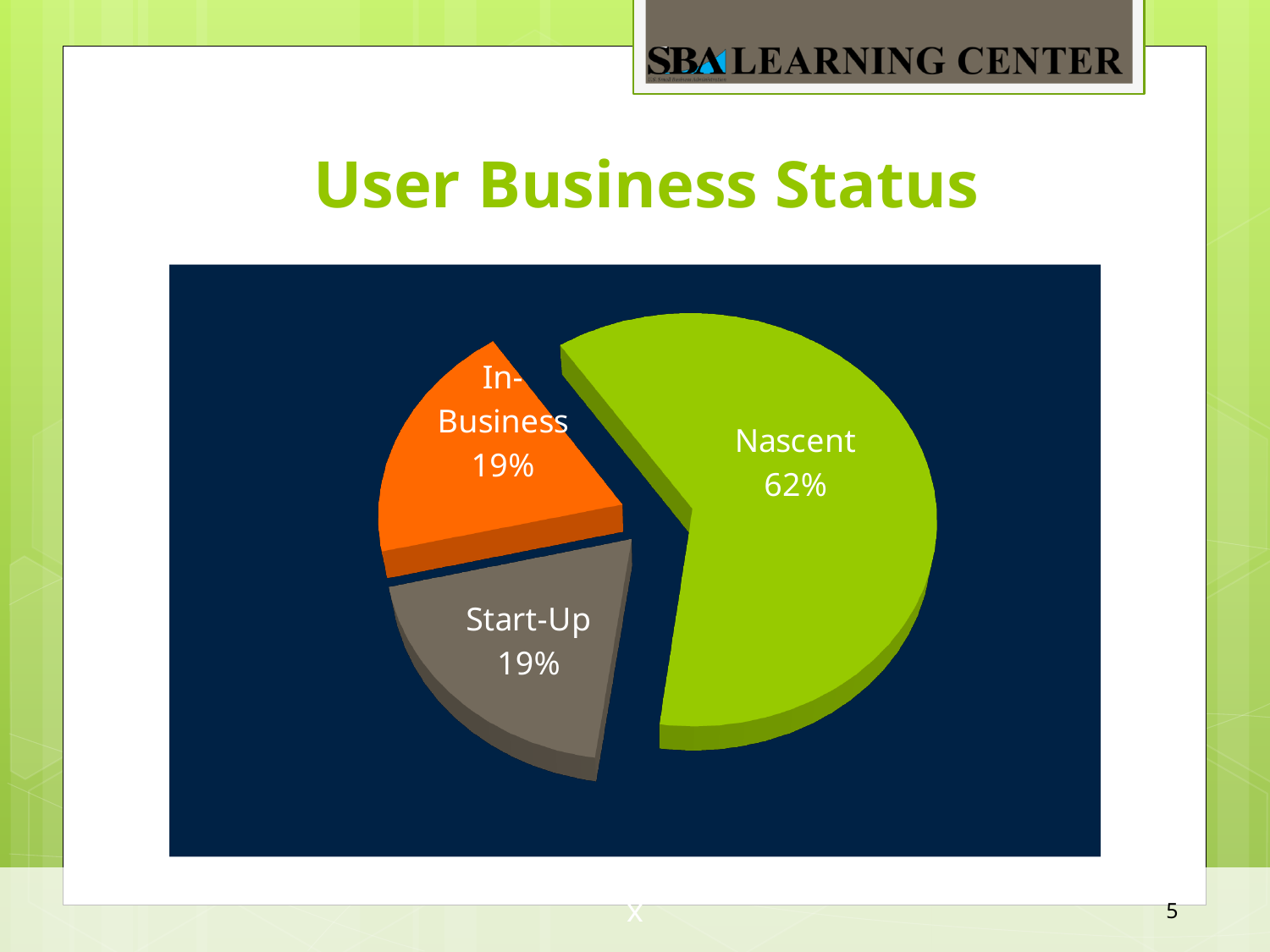
What is the difference in percentage points between the Nascent and Start-Up shares? 43 What colour is the Nascent slice? green What is the title of the slide containing the pie chart? User Business Status What share of users are In-Business? 19% How many slices does the pie chart have? 3 Which business status has the largest share? Nascent What share of users are Start-Up? 19% What is the combined share of Start-Up and In-Business users? 38% Which is larger, the Nascent share or the In-Business share? Nascent What kind of chart is shown on the slide? pie chart What share of users are Nascent? 62%